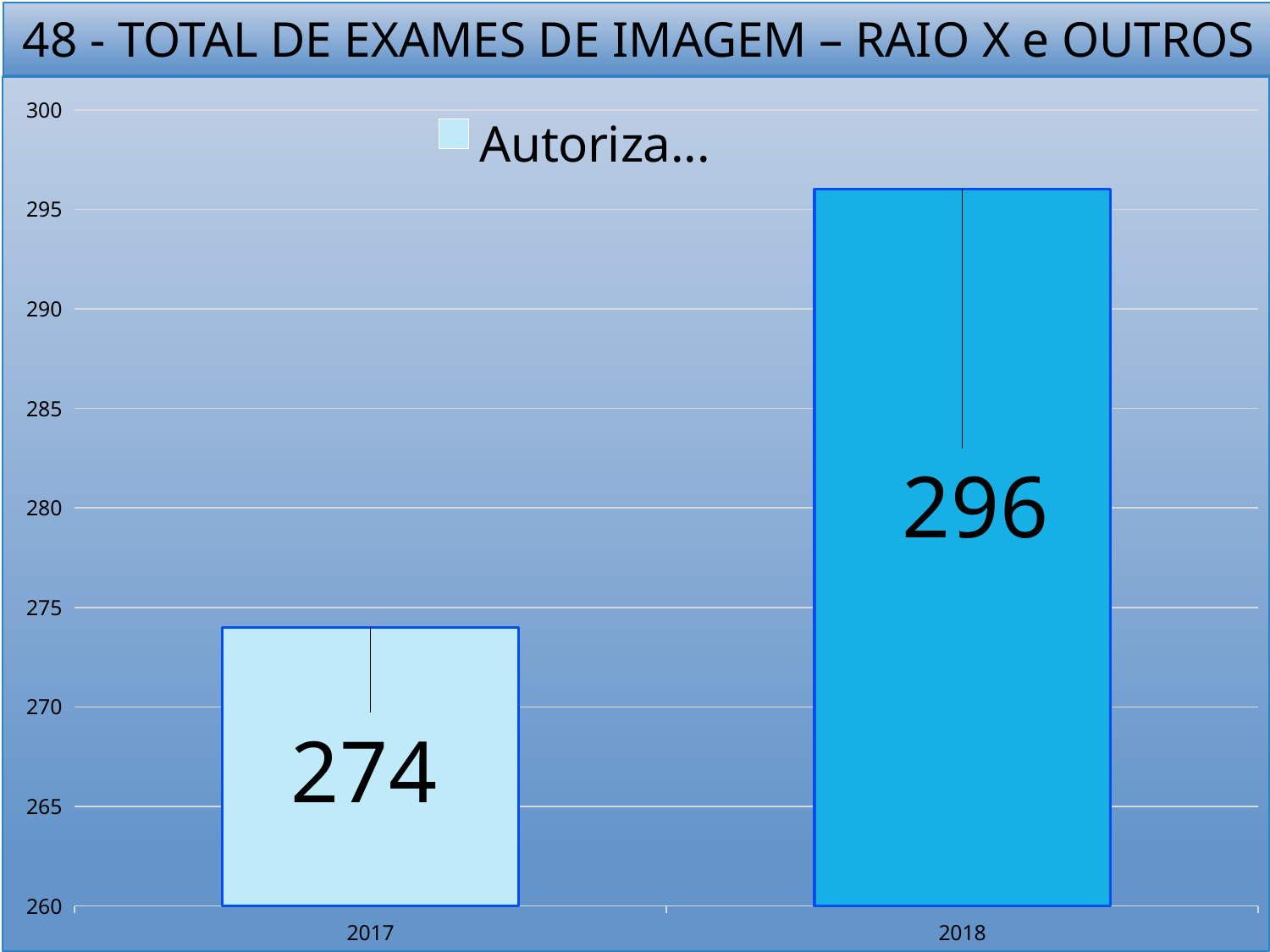
Do the values rise or fall from 2017 to 2018? rise What kind of chart is shown on the slide? bar chart Which year has the lowest value? 2017 How many categories are shown on the x axis? 2 Is the value for 2018 greater or less than 290? greater Which is larger, the value for 2017 or the value for 2018? 2018 What is the title of the chart? 48 - TOTAL DE EXAMES DE IMAGEM – RAIO X e OUTROS What is the difference between the values for 2018 and 2017? 22 What is the value for 2018? 296 What is the value for 2017? 274 Which year has the highest value? 2018 Is the value for 2017 greater or less than 280? less